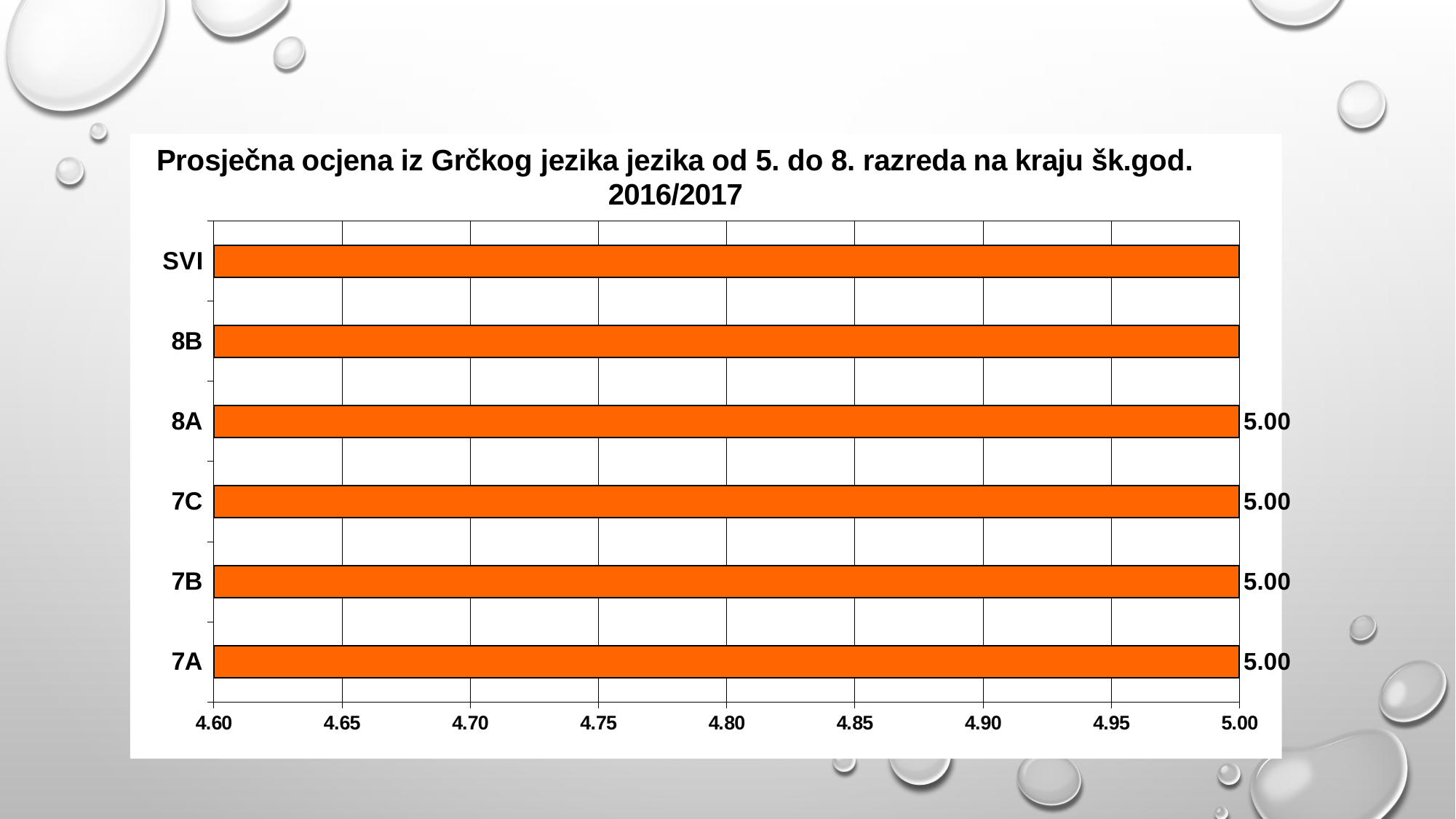
What is the value for 8A? 5.00 What is the lowest value shown on the horizontal axis? 4.60 What is the value for 7A? 5.00 What is the value for 7C? 5.00 How many categories are shown on the chart? 6 What is the value for 7B? 5.00 What kind of chart is shown on the slide? bar chart What is the difference between the values for 7A and 8A? 0.00 Is the value for 8B greater or less than 4.90? greater Which school year is named in the chart title? 2016/2017 Is the value for SVI greater or less than 4.80? greater